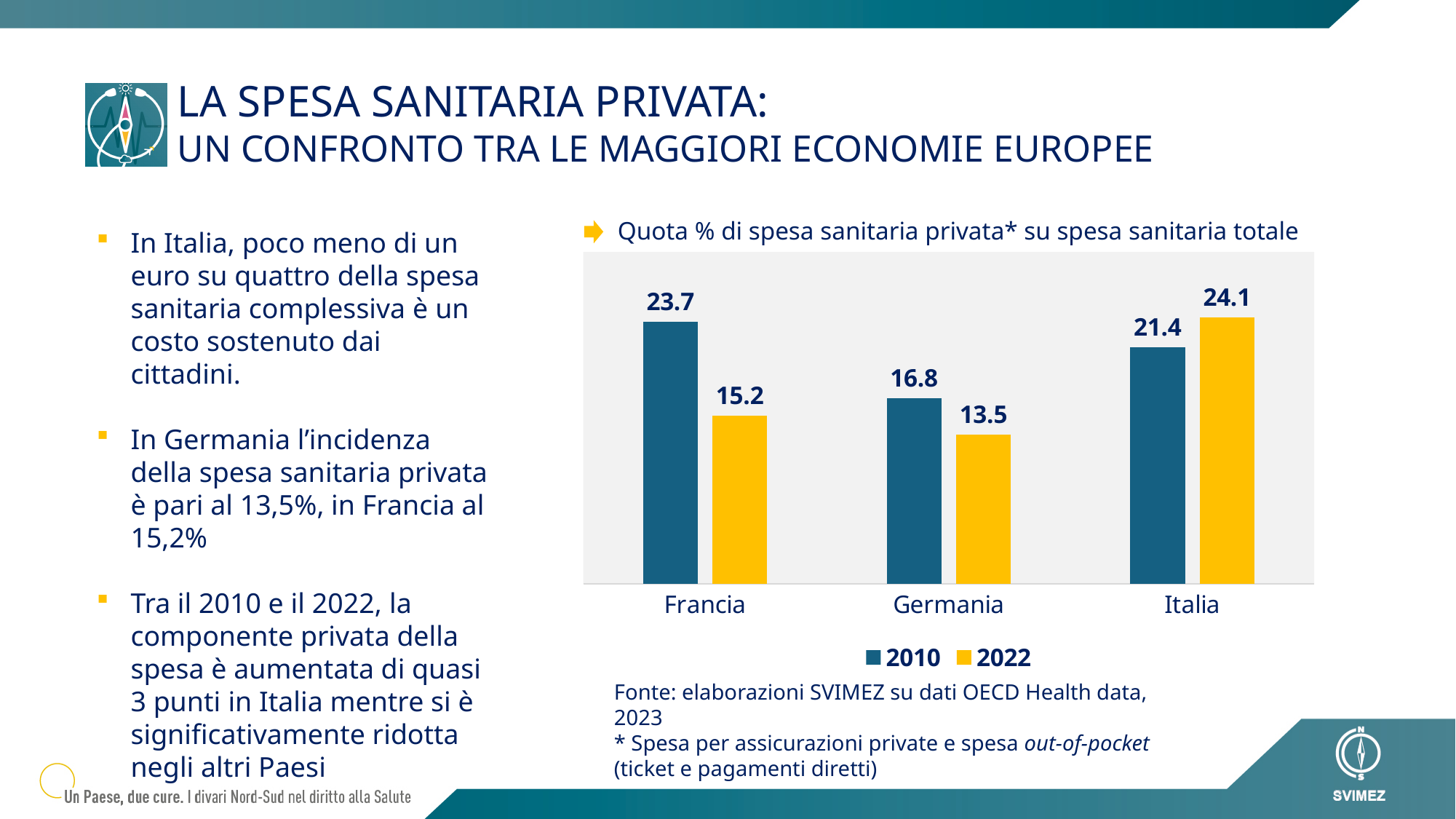
What is the value for Italia in the 2022 series? 24.1 How many countries are shown on the x axis of the chart? 3 Which country has the highest value in the 2022 series? Italia What is the value for Francia in the 2010 series? 23.7 What is the difference between the 2022 and 2010 values for Italia? 2.7 Which colour represents the 2022 series in the chart? Yellow Which country has the lowest value in the 2010 series? Germania What kind of chart is shown on the slide? Bar chart What is the difference between the 2010 and 2022 values for Francia? 8.5 Which is larger for Germania, the 2010 value or the 2022 value? 2010 What is the value for Germania in the 2022 series? 13.5 How many series does the legend list? 2